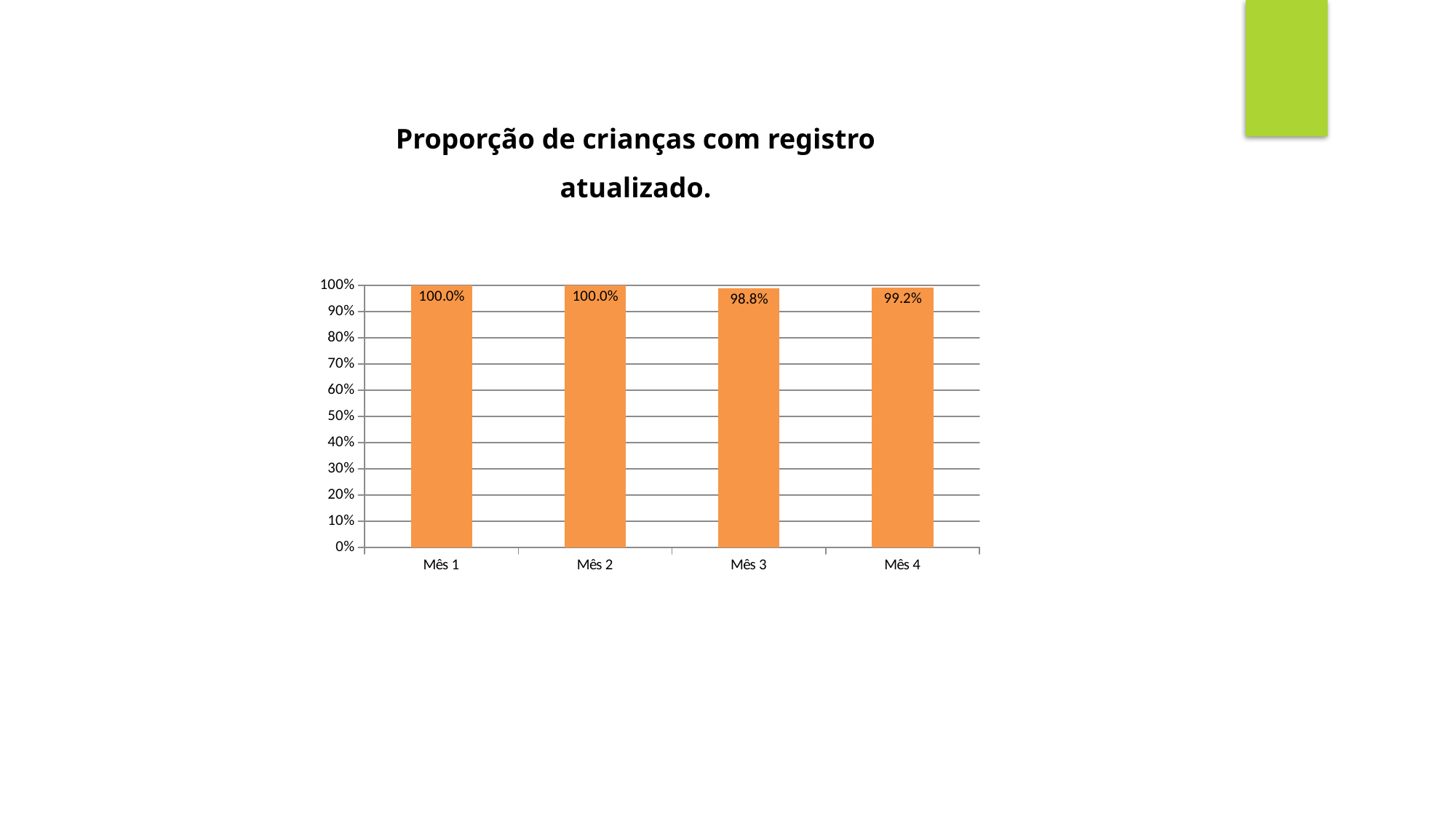
What is the difference between the values for Mês 4 and Mês 3? 0.4% What is the value for Mês 3? 98.8% How many categories are shown on the x axis? 4 What colour are the bars in the chart? Orange What is the difference between the values for Mês 2 and Mês 3? 1.2% What kind of chart is shown on the slide? Bar chart What is the value for Mês 1? 100.0% What is the value for Mês 4? 99.2% Which is larger, the value for Mês 3 or the value for Mês 4? Mês 4 What is the title of the chart? Proporção de crianças com registro atualizado. Which month has the lowest value? Mês 3 Is the value for Mês 3 greater or less than 90%? greater